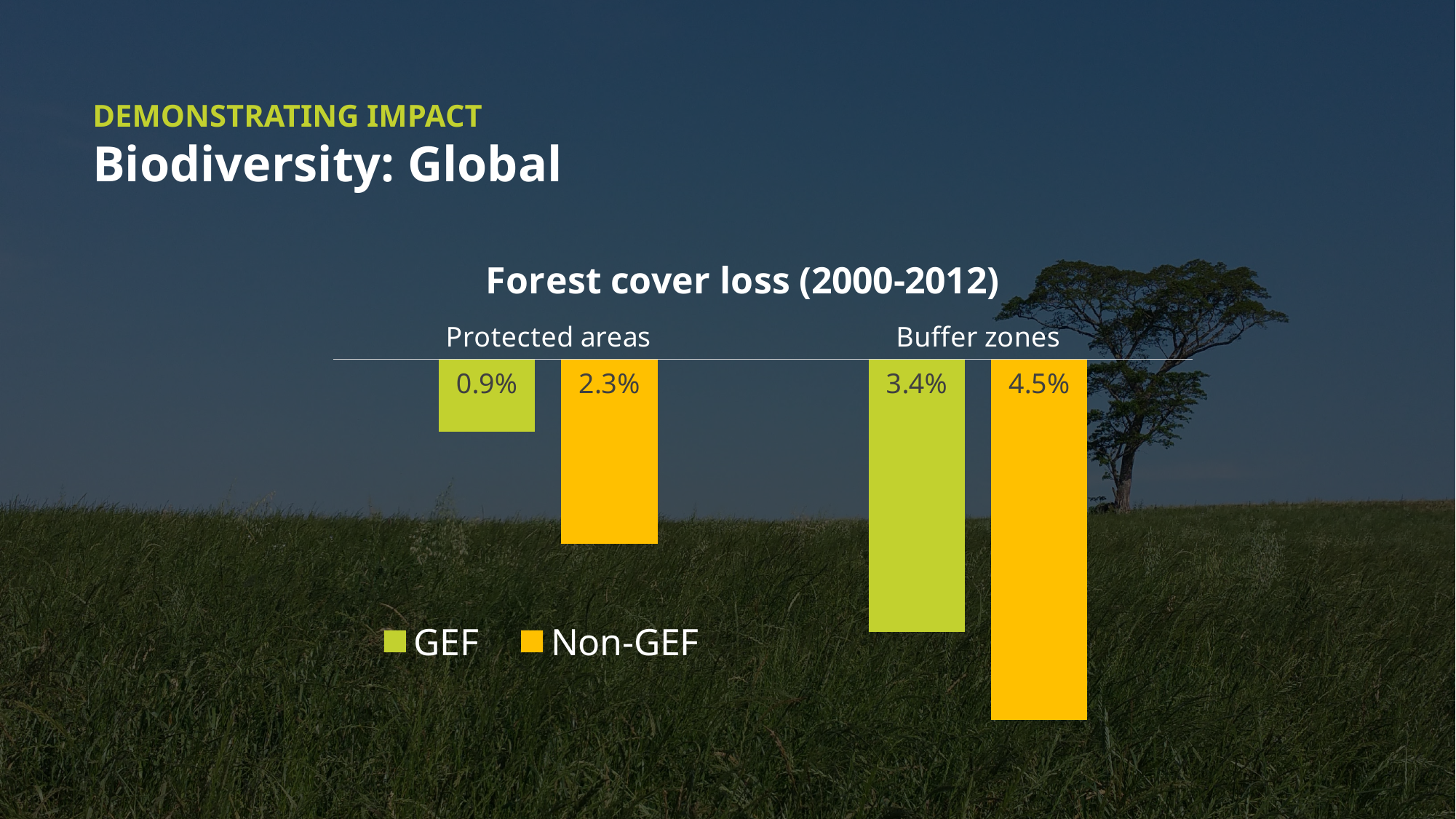
How many categories are shown on the x axis? 2 How many series does the legend list? 2 What is the difference between Non-GEF and GEF forest cover loss in Buffer zones? 1.1% Which bar shows the highest forest cover loss? Non-GEF, Buffer zones What is the forest cover loss for Non-GEF in Buffer zones? 4.5% Which is larger: GEF forest cover loss in Buffer zones or Non-GEF forest cover loss in Protected areas? GEF in Buffer zones What is the forest cover loss for GEF in Buffer zones? 3.4% What is the forest cover loss for Non-GEF in Protected areas? 2.3% What is the title of the chart? Forest cover loss (2000-2012) What is the difference between Non-GEF and GEF forest cover loss in Protected areas? 1.4% Which bar shows the lowest forest cover loss? GEF, Protected areas What is the forest cover loss for GEF in Protected areas? 0.9%